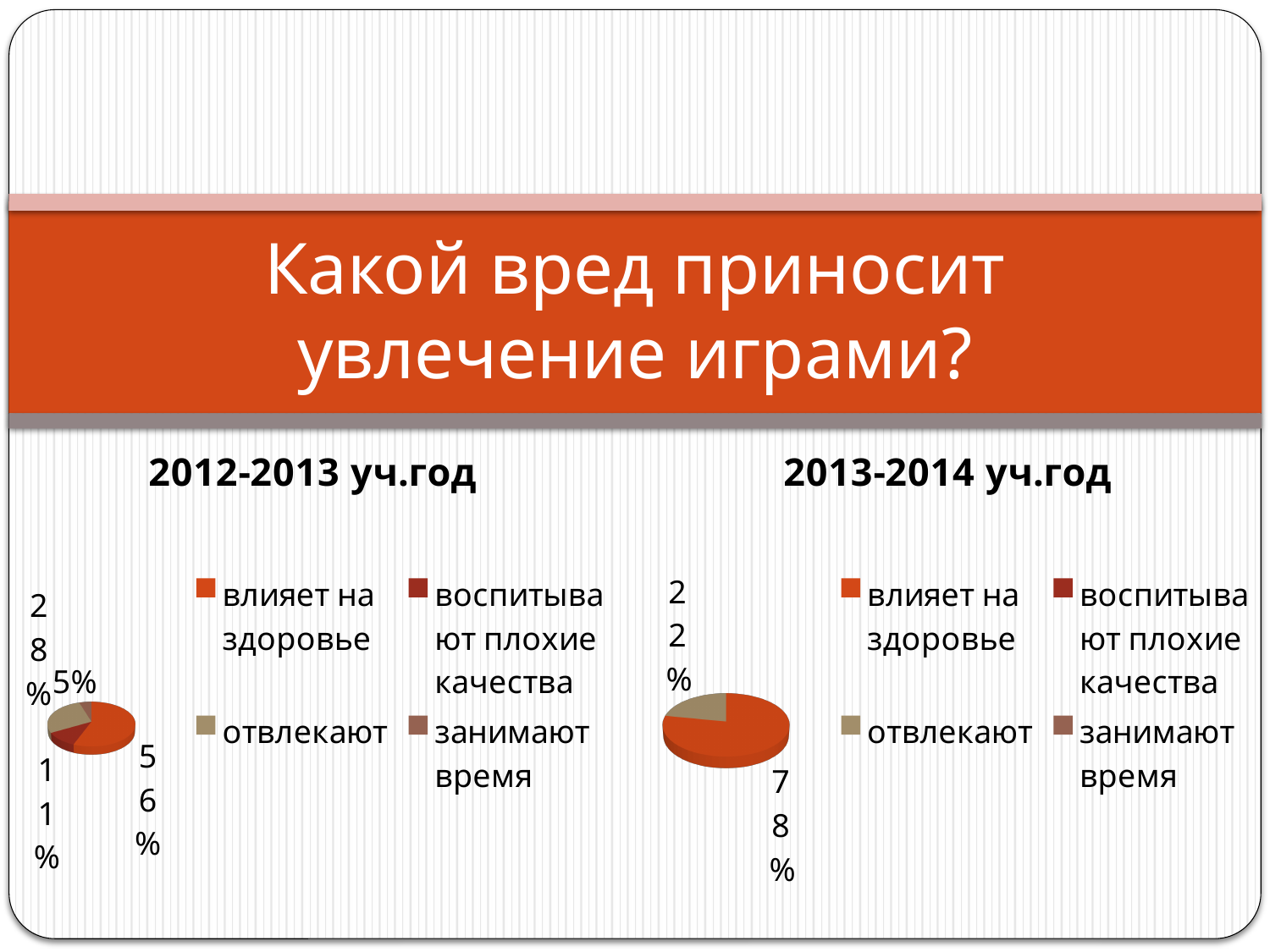
In the 2013-2014 уч.год chart, what is the difference between the 'влияет на здоровье' share and the 'отвлекают' share? 56 percentage points By how many percentage points does the 'влияет на здоровье' share in the 2013-2014 уч.год chart exceed that in the 2012-2013 уч.год chart? 22 percentage points In the 2012-2013 уч.год chart, which category has the largest slice? влияет на здоровье In the 2013-2014 уч.год chart, what percentage is shown for 'отвлекают'? 22% Is the share of 'влияет на здоровье' larger in the 2012-2013 уч.год chart or the 2013-2014 уч.год chart? 2013-2014 уч.год How many slices does the 2013-2014 уч.год pie chart have? 2 How many entries does the legend of the 2013-2014 уч.год chart list? 4 What type of chart is used on this slide for the 2012-2013 уч.год and 2013-2014 уч.год data? Pie chart What is the smallest percentage labelled on the 2012-2013 уч.год chart? 5% In the 2012-2013 уч.год chart, what percentage is shown for 'влияет на здоровье'? 56% How many slices does the 2012-2013 уч.год pie chart have? 4 In the 2013-2014 уч.год chart, what percentage is shown for 'влияет на здоровье'? 78%